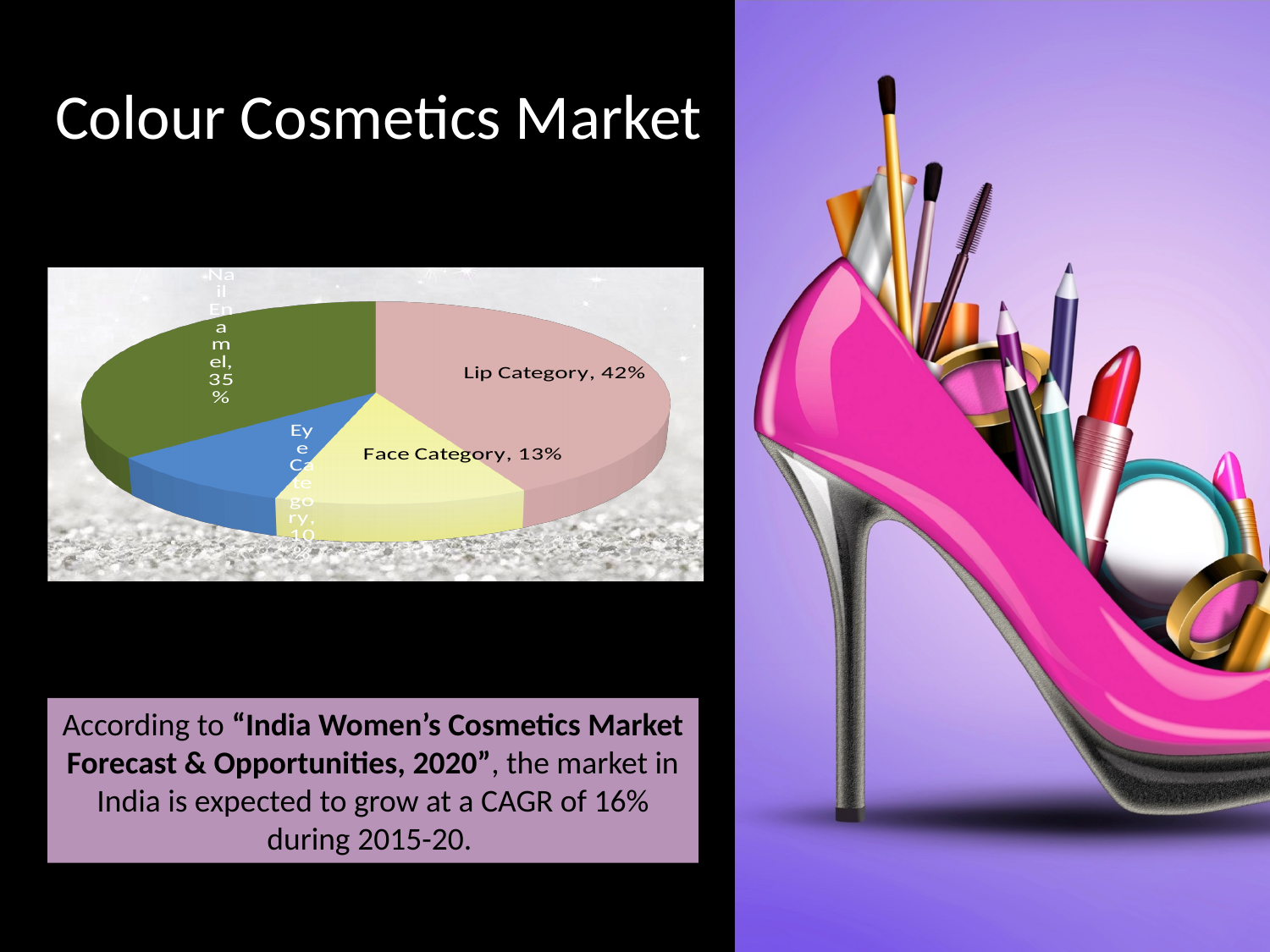
What colour is the Lip Category slice? pink What share of the pie does Nail Enamel hold? 35% Which is larger, the Face Category share or the Eye Category share? Face Category Which category has the smallest slice of the pie? Eye Category How many slices does the pie chart have? 4 What share of the pie does the Face Category hold? 13% What share of the pie does the Eye Category hold? 10% What is the difference in percentage points between the Lip Category and Nail Enamel? 7 What share of the pie does the Lip Category hold? 42% What kind of chart is shown on the slide? pie chart Which category has the largest slice of the pie? Lip Category What is the combined share of the Lip Category and Nail Enamel? 77%